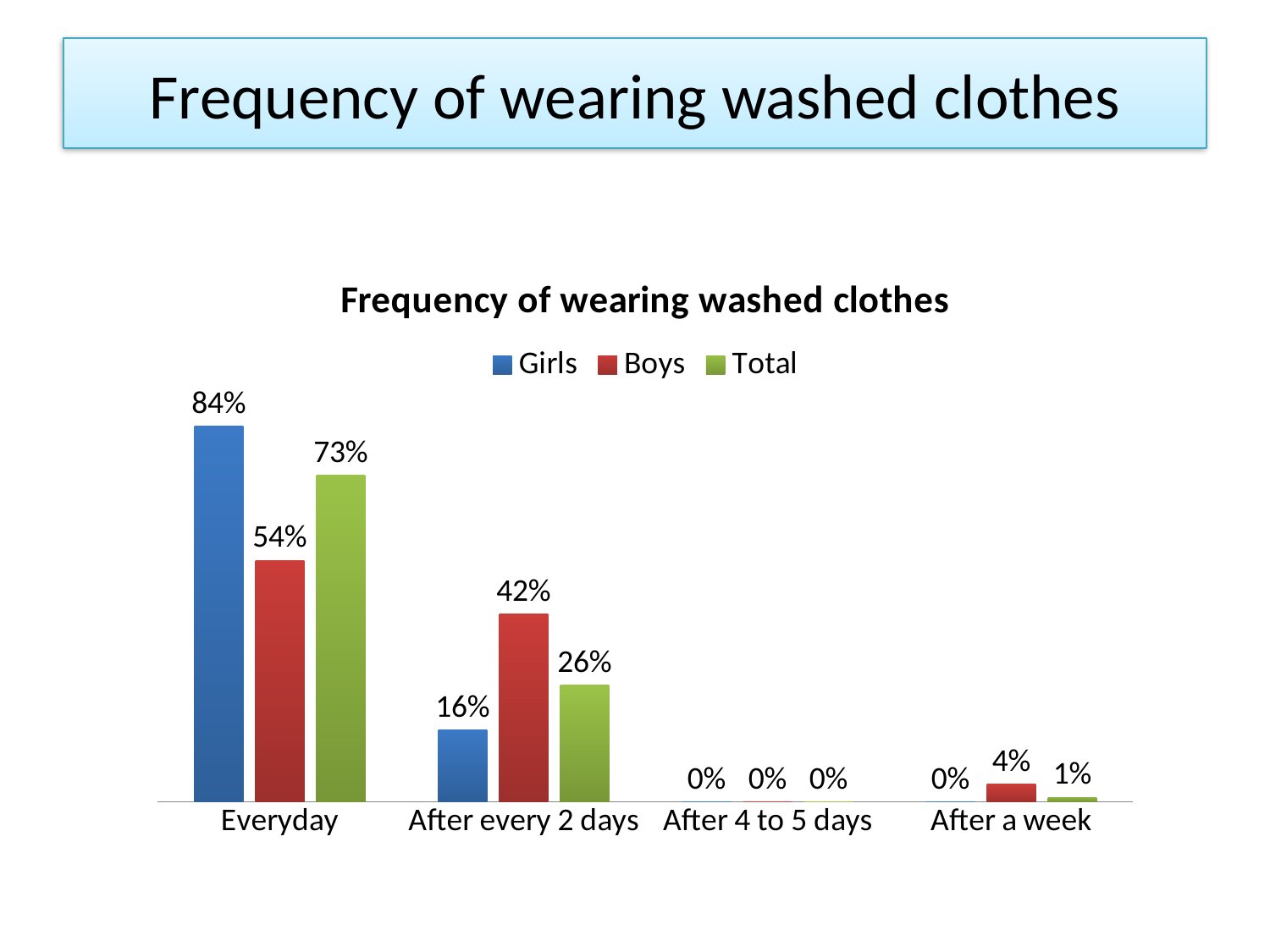
What is the Total value for After a week? 1% How many series does the legend list? 3 Which category has the lowest value for Total? After 4 to 5 days What is the value for Girls in the Everyday category? 84% How many categories are shown on the x axis? 4 Do the Total values rise or fall from Everyday to After 4 to 5 days? Fall What colour represents the Boys series in the chart? Red What kind of chart is shown on the slide? Bar chart Which category has the highest value for Girls? Everyday What is the difference between the Girls and Boys values in the Everyday category? 30% In the After every 2 days category, which is larger, the Girls value or the Boys value? Boys What is the value for Boys in the After every 2 days category? 42%